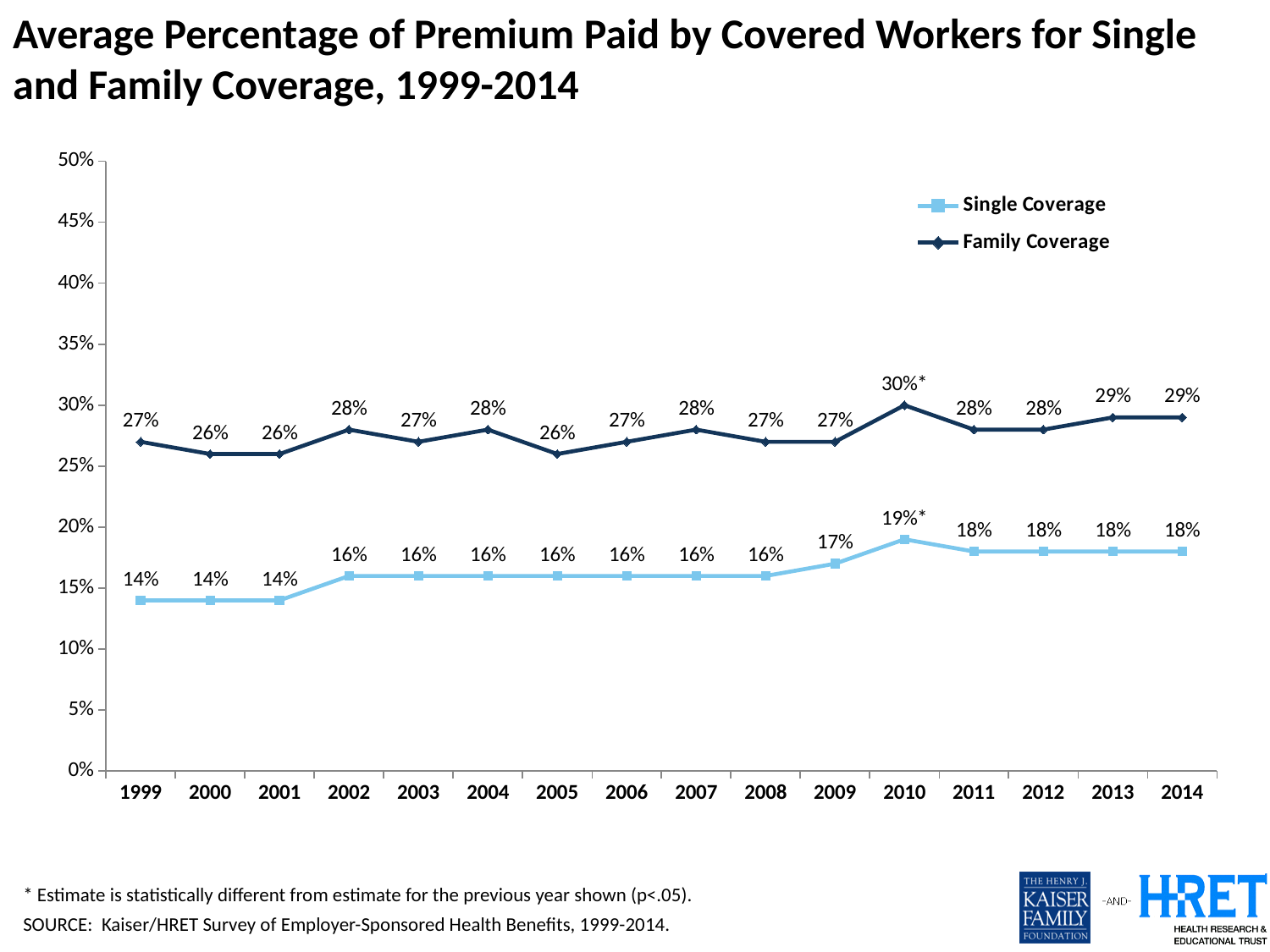
What is the difference between the Single Coverage values in 2010 and 2009? 2 percentage points What is the value for Single Coverage in 2014? 18% How many years are shown on the x axis? 16 What type of chart is shown on the slide? Line chart How many series does the legend list? 2 In which year is the Single Coverage value highest? 2010 In which year is the Family Coverage value highest? 2010 Which is larger in 2012, Family Coverage or Single Coverage? Family Coverage Overall, does the Single Coverage line rise or fall from 1999 to 2014? Rise What is the value for Family Coverage in 2005? 26% What is the value for Family Coverage in 2010? 30% What is the difference between Family Coverage and Single Coverage in 1999? 13 percentage points